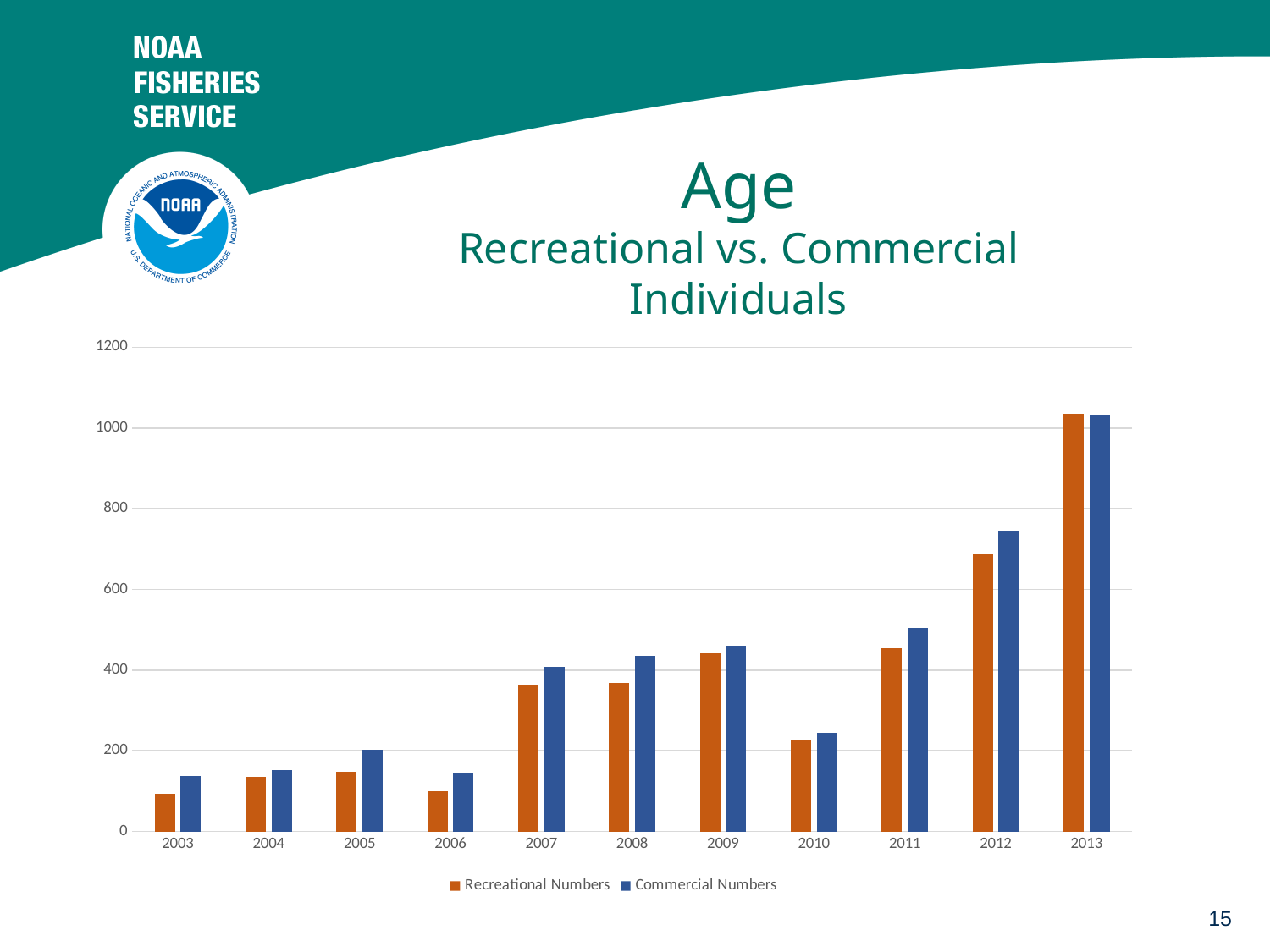
Which year has the highest Commercial Numbers value? 2013 What kind of chart is shown on the slide? bar chart Which colour represents Recreational Numbers in the legend? orange Is the Commercial Numbers value for 2013 greater or less than 1000? greater How many series does the legend list? 2 Is the Recreational Numbers value for 2003 greater or less than 200? less Is the Recreational Numbers value for 2012 greater or less than 600? greater Which year has the highest Recreational Numbers value? 2013 Do the Commercial Numbers values rise or fall from 2010 to 2013? rise In 2012, which is larger: Recreational Numbers or Commercial Numbers? Commercial Numbers How many years are shown on the x axis? 11